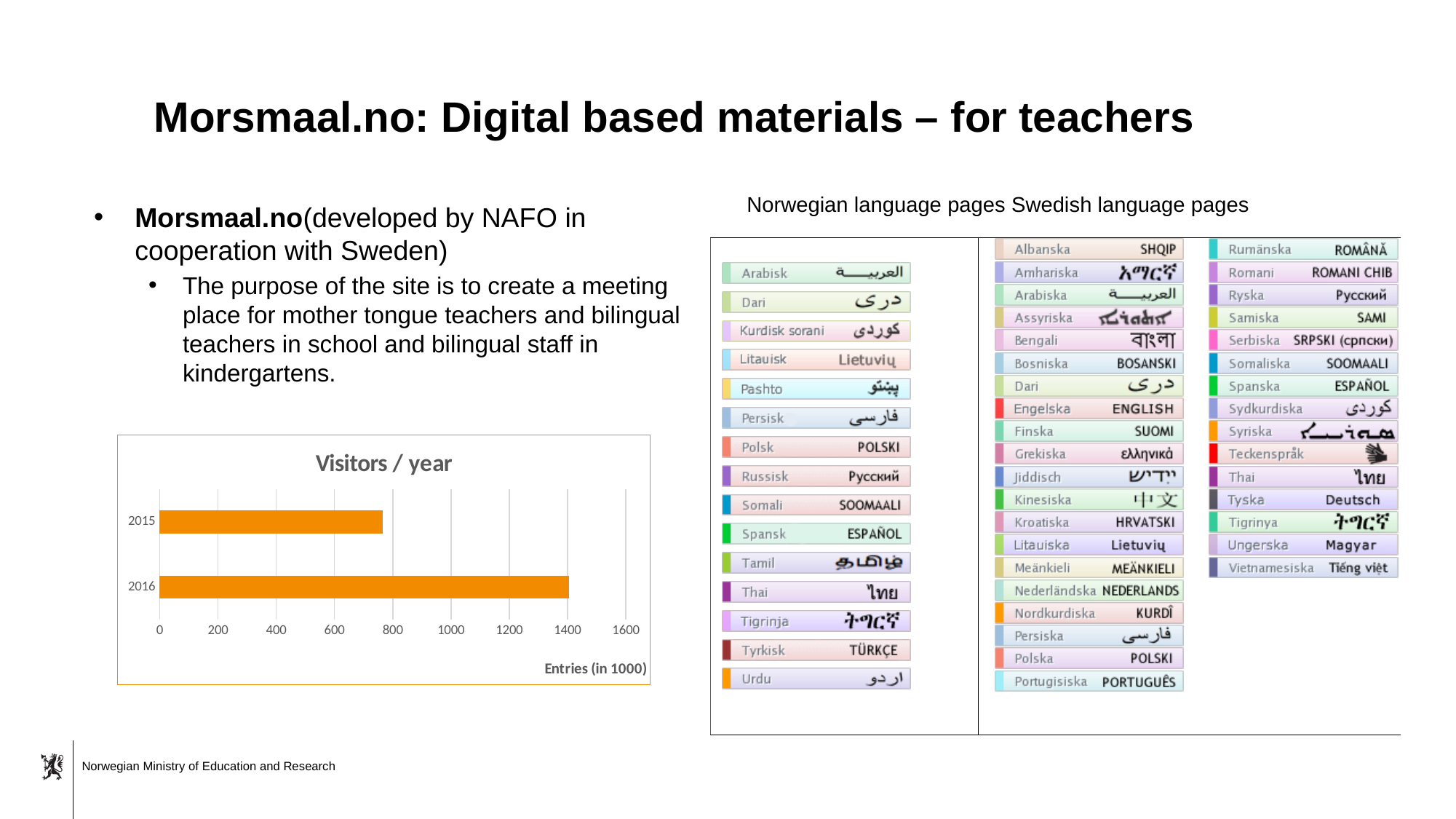
In the "Visitors / year" chart, is the value for 2015 greater or less than 1000? less In the "Visitors / year" chart, is the value for 2016 greater or less than 1200? greater Which year has the lowest number of visitors in the "Visitors / year" chart? 2015 Do the visitor numbers rise or fall from 2015 to 2016 in the "Visitors / year" chart? rise In the "Visitors / year" chart, is the value for 2016 greater or less than 1600? less What kind of chart is the "Visitors / year" chart? bar chart How many years are shown in the "Visitors / year" chart? 2 What is the title of the bar chart on the slide? Visitors / year In the "Visitors / year" chart, which year has more visitors, 2015 or 2016? 2016 What unit label is shown on the horizontal axis of the "Visitors / year" chart? Entries (in 1000) Which year has the highest number of visitors in the "Visitors / year" chart? 2016